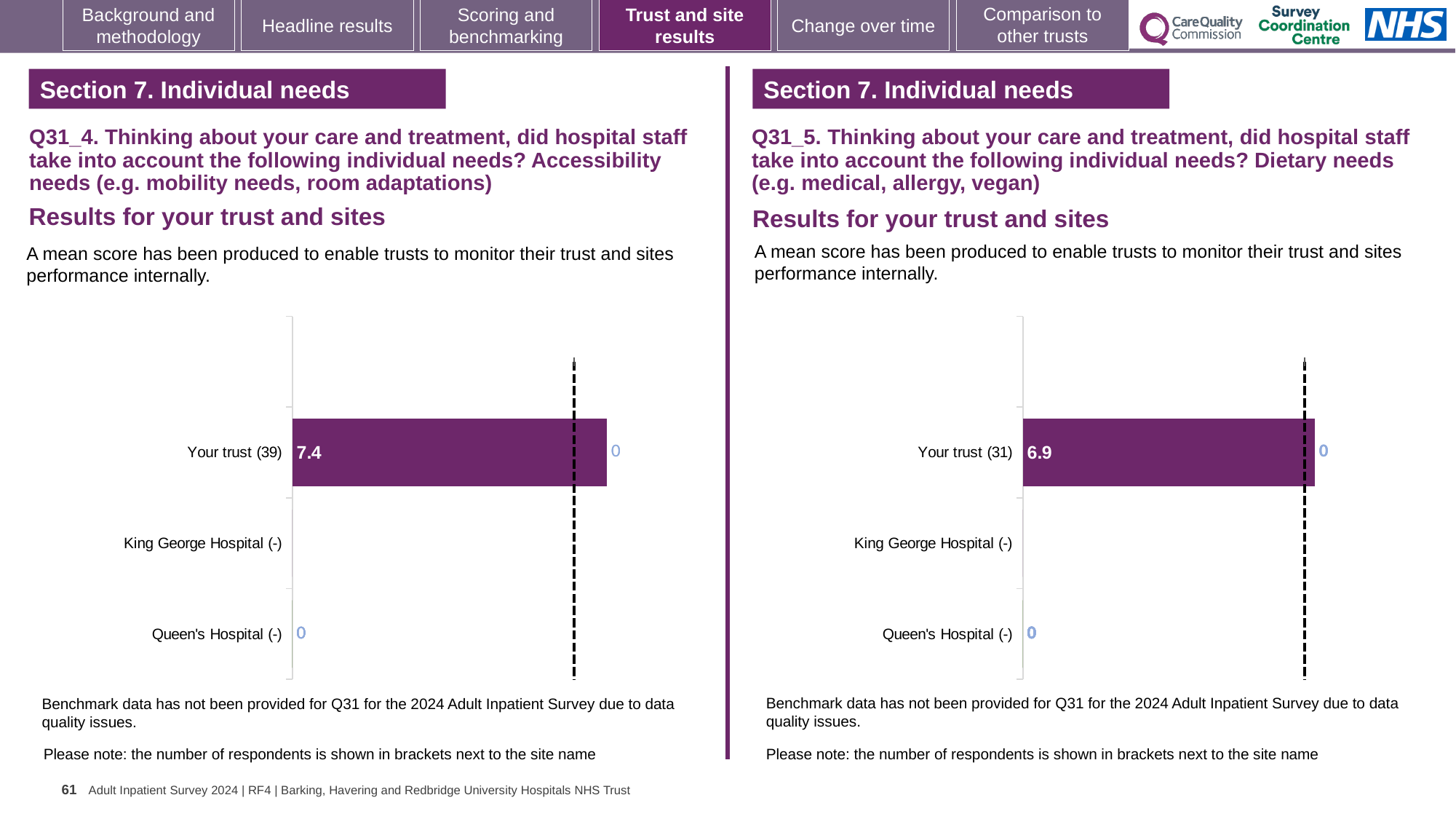
In the right chart (Q31_5), which category has the highest score? Your trust What kind of chart is the left chart (Q31_4)? Bar chart In the left chart (Q31_4, Accessibility needs), what is the mean score for Your trust? 7.4 How many categories are listed on the y axis of the left chart (Q31_4)? 3 In the left chart (Q31_4), how many respondents are shown in brackets next to Your trust? 39 In the right chart (Q31_5, Dietary needs), what is the mean score for Your trust? 6.9 In the right chart (Q31_5), how many respondents are shown in brackets next to Your trust? 31 In the left chart (Q31_4), which category has the highest score? Your trust What is the difference between the Your trust score in the left chart (Q31_4) and the Your trust score in the right chart (Q31_5)? 0.5 How many categories are listed on the y axis of the right chart (Q31_5)? 3 What kind of chart is the right chart (Q31_5)? Bar chart Which is larger: the Your trust score in the left chart (Q31_4) or the Your trust score in the right chart (Q31_5)? Left chart (Q31_4), 7.4